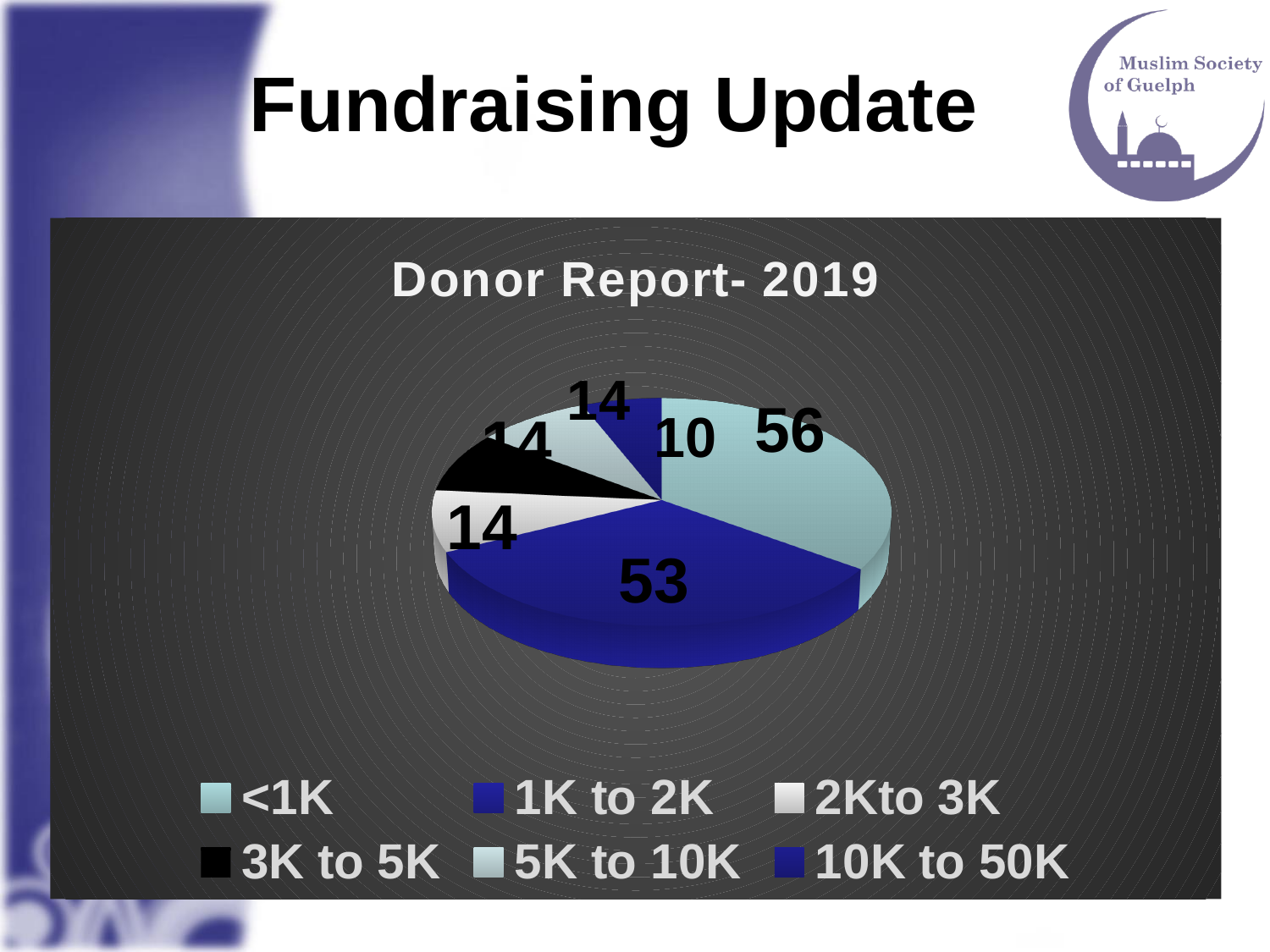
How many categories does the legend of the pie chart list? 6 Which is larger, the value for 1K to 2K or the value for 2K to 3K? 1K to 2K What is the sum of all the values labelled on the pie chart? 161 What type of chart is shown on the slide? pie chart What is the title of the chart? Donor Report- 2019 What is the value for the 1K to 2K category? 53 What is the value for the 3K to 5K category? 14 Which category has the largest slice of the pie? <1K What is the value for the <1K category? 56 What is the difference between the values for <1K and 1K to 2K? 3 What is the smallest value labelled on the pie chart? 10 What is the value for the 2K to 3K category? 14